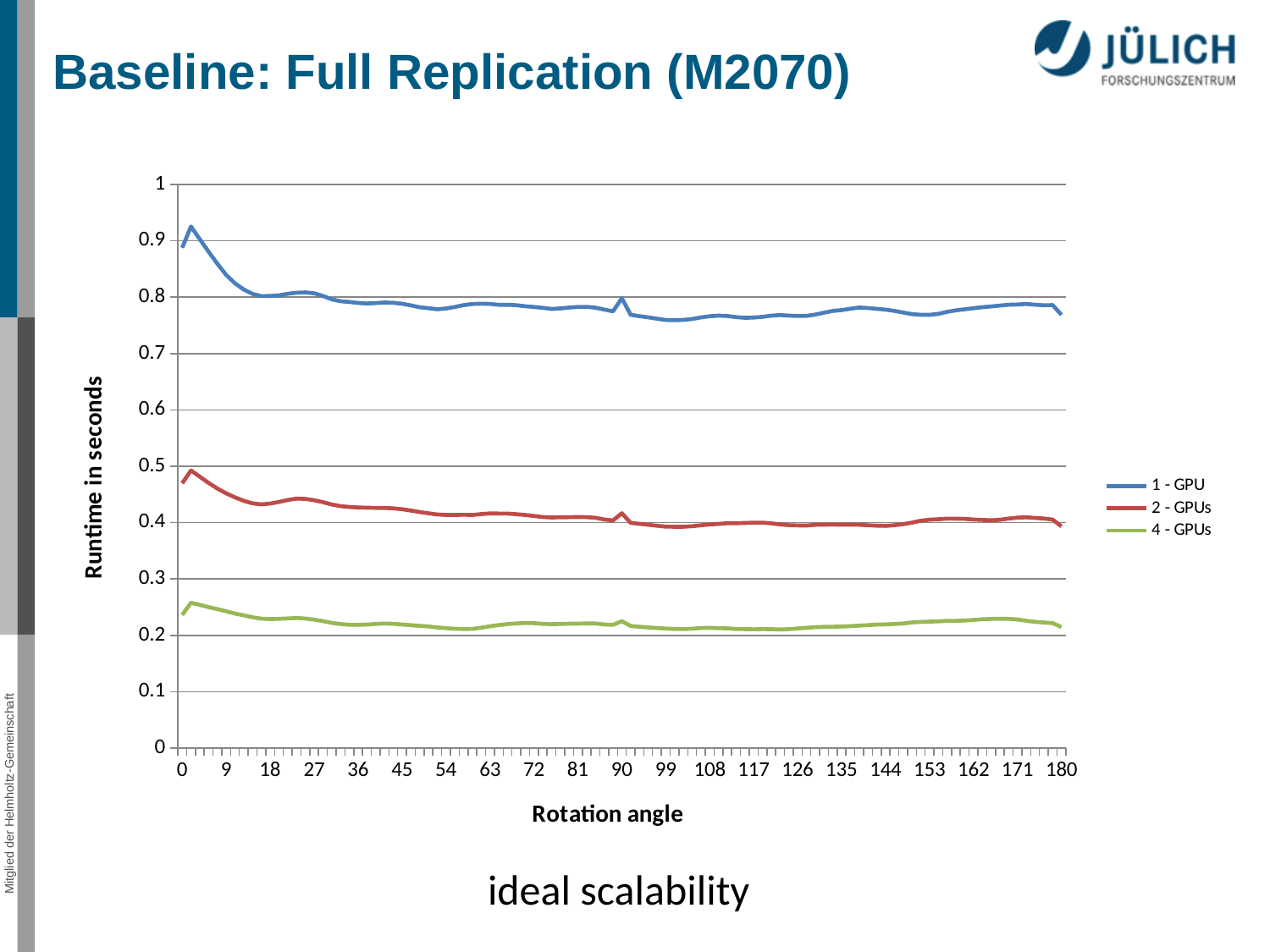
How many series does the legend list? 3 Which series has the highest runtime across the rotation angles? 1 - GPU Is the runtime for 1 - GPU at rotation angle 90 greater or less than 0.7? greater Is the runtime for 2 - GPUs at rotation angle 180 greater or less than 0.5? less What is the title of the x axis? Rotation angle Does the runtime for 1 - GPU generally rise or fall as the rotation angle increases from 0 to 180? fall What kind of chart is shown on the slide? line chart At rotation angle 90, which is larger: the runtime for 1 - GPU or for 4 - GPUs? 1 - GPU Is the runtime for 1 - GPU at rotation angle 0 greater or less than 0.8? greater What is the title of the y axis? Runtime in seconds Which series has the lowest runtime across the rotation angles? 4 - GPUs